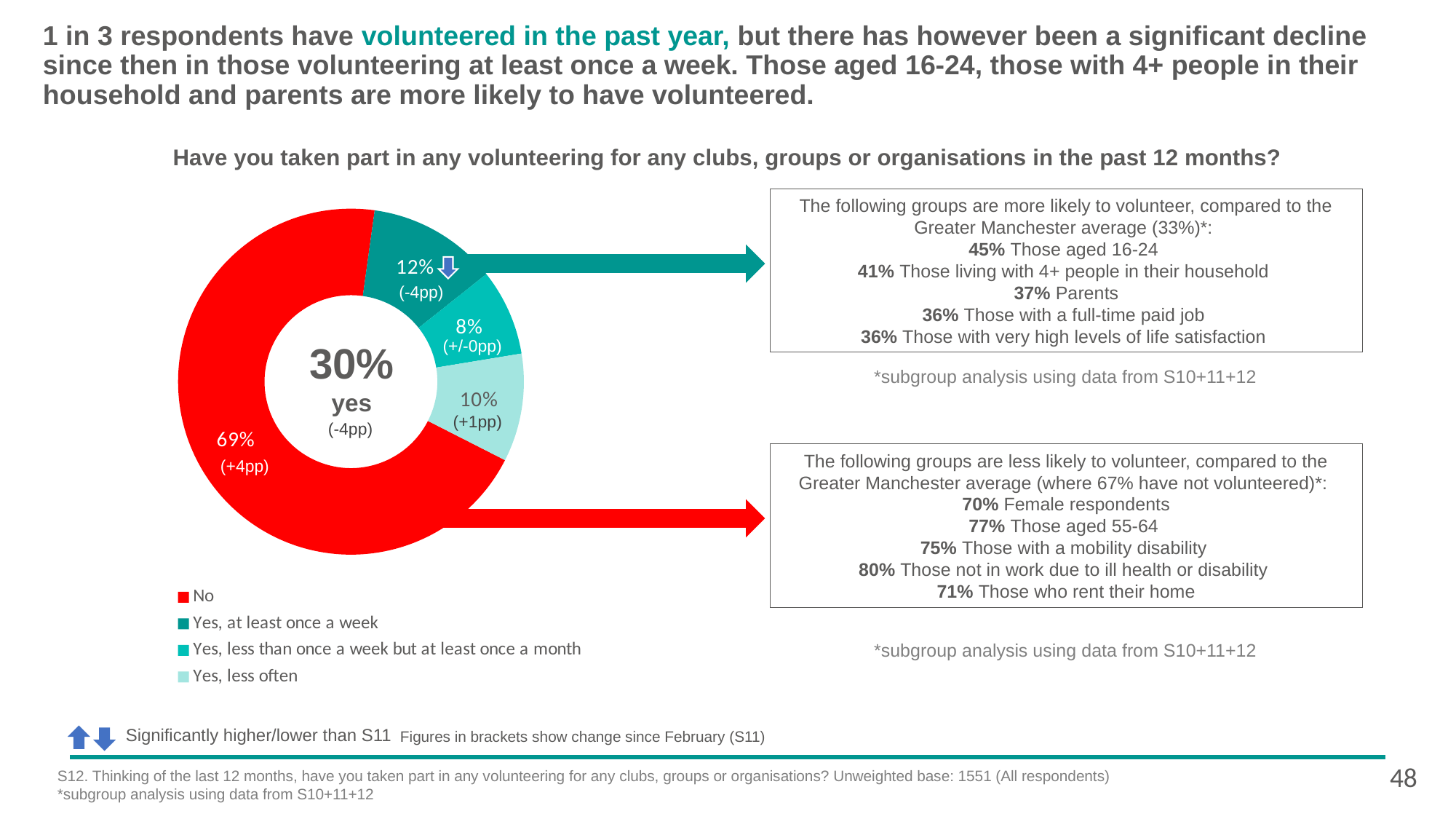
How many categories does the pie chart legend list? 4 Which category has the smallest share of the pie chart? Yes, less than once a week but at least once a month What percentage of respondents said "Yes, less than once a week but at least once a month"? 8% What percentage of respondents answered "No" to having volunteered in the past 12 months? 69% Which is larger: the share for "Yes, less often" or the share for "Yes, less than once a week but at least once a month"? Yes, less often What percentage of respondents said "Yes, less often"? 10% What percentage of respondents said "Yes, at least once a week"? 12% What change since February is shown in brackets for the "No" slice? +4pp Which category has the largest share of the pie chart? No What overall percentage of respondents said yes, as shown in the centre of the donut chart? 30% What kind of chart is shown on the slide? Pie chart (donut) What is the difference in percentage points between "No" and "Yes, at least once a week"? 57 percentage points